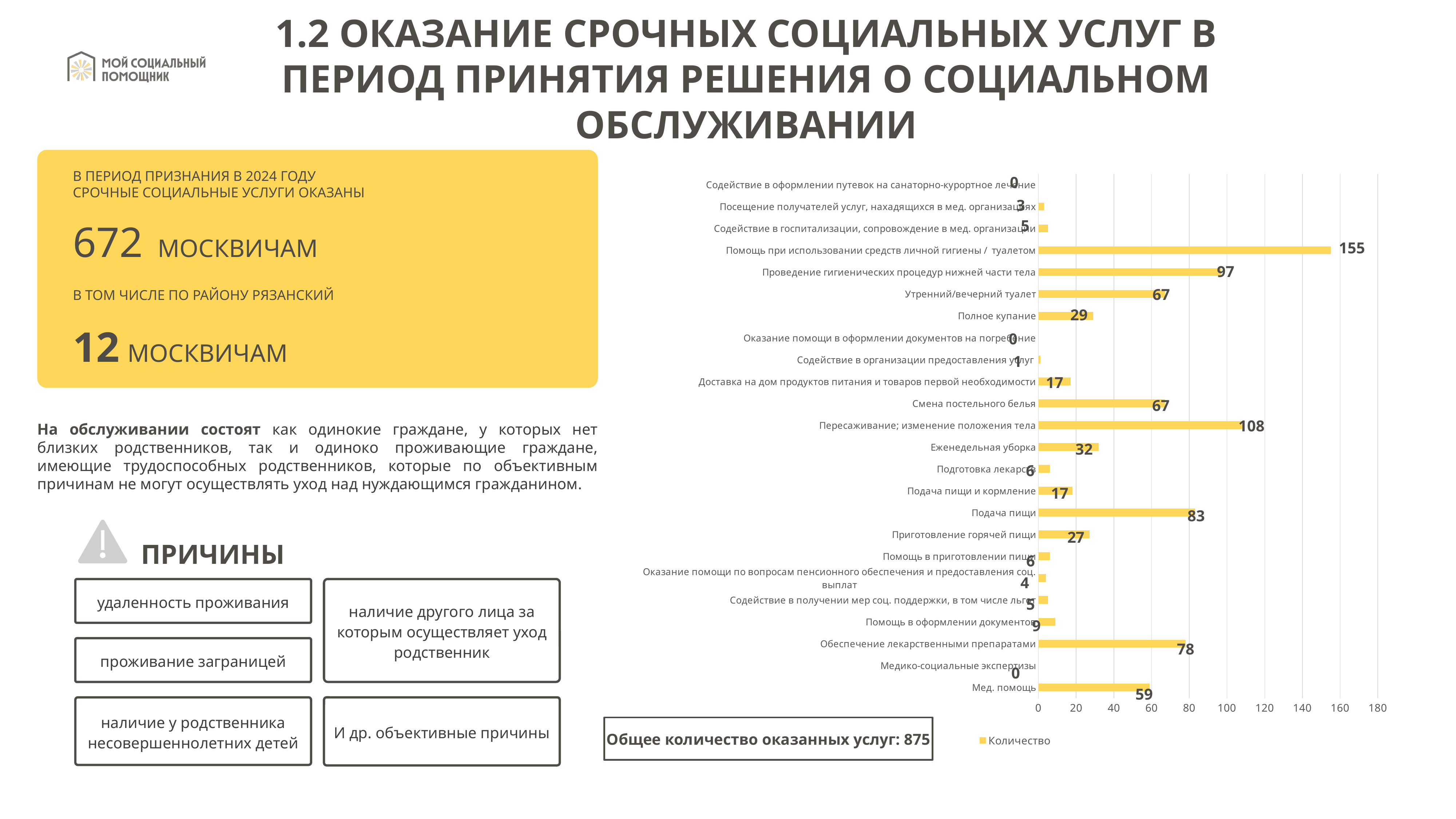
What is the value for "Мед. помощь"? 59 What is the value for "Обеспечение лекарственными препаратами"? 78 How many categories are shown in the chart? 24 What is the value for "Пересаживание; изменение положения тела"? 108 What is the difference between the values for "Проведение гигиенических процедур нижней части тела" and "Полное купание"? 68 Which is larger: the value for "Подача пищи" or the value for "Обеспечение лекарственными препаратами"? Подача пищи What is the name of the series shown in the legend? Количество How many series does the legend list? 1 What type of chart is shown on the slide? bar chart Is the value for "Пересаживание; изменение положения тела" greater or less than 100? greater Which category has the highest value? Помощь при использовании средств личной гигиены / туалетом What is the value for "Помощь при использовании средств личной гигиены / туалетом"? 155